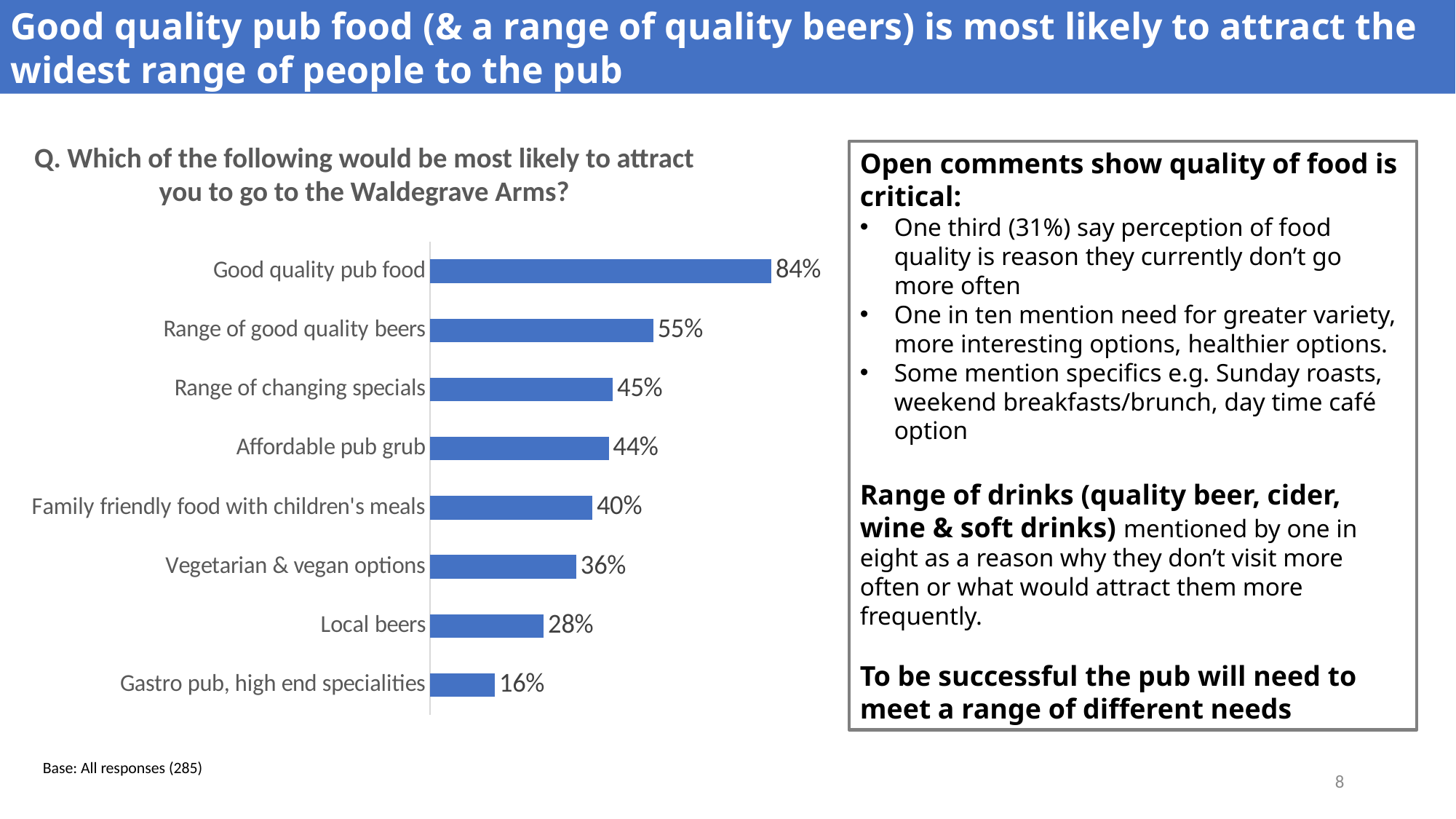
What is the difference in percentage points between 'Good quality pub food' and 'Range of good quality beers'? 29 What percentage is shown for 'Vegetarian & vegan options'? 36% What is the difference in percentage points between 'Family friendly food with children's meals' and 'Gastro pub, high end specialities'? 24 What is the value shown for 'Range of good quality beers'? 55% What type of chart is used on this slide? Bar chart What percentage of respondents said good quality pub food would be most likely to attract them to the Waldegrave Arms? 84% Which has a higher value: 'Range of changing specials' or 'Affordable pub grub'? Range of changing specials Which option has the highest percentage in the chart? Good quality pub food How many options (categories) are shown in the chart? 8 What is the value for 'Local beers'? 28% Which option has the lowest percentage in the chart? Gastro pub, high end specialities What is the base (number of responses) stated for the chart? All responses (285)